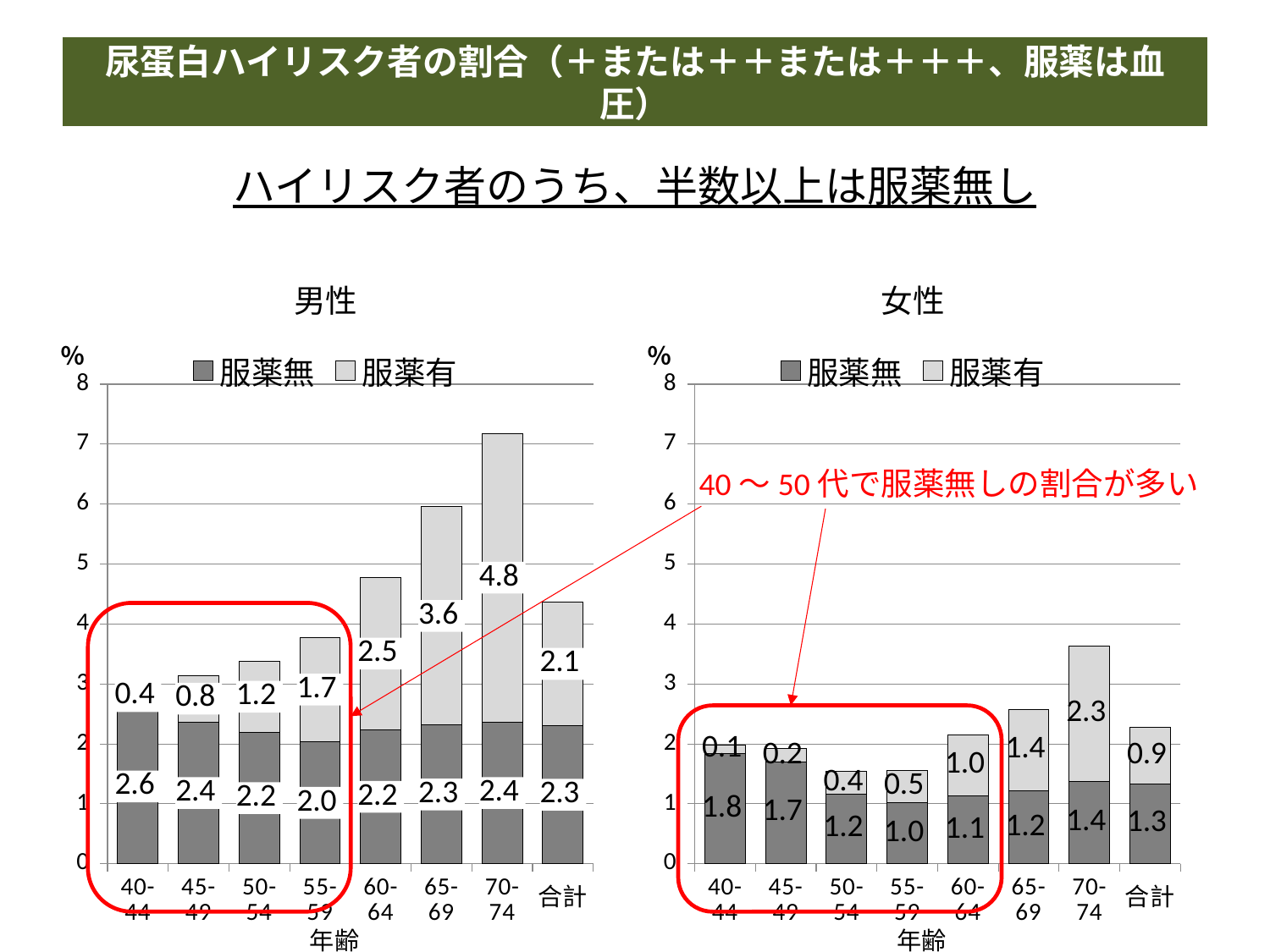
In the 男性 chart, what is the 服薬無 value for the 40-44 age group? 2.6 In the 男性 chart, what is the total height of the stacked bar for the 70-74 age group? 7.2 In the 女性 chart, what is the 服薬有 value for 合計? 0.9 In the 男性 chart, which is larger for the 65-69 age group: 服薬無 or 服薬有? 服薬有 In the 女性 chart, what is the 服薬無 value for the 55-59 age group? 1.0 What kind of chart is the 女性 chart? Stacked bar chart In the 女性 chart, which age group has the lowest 服薬有 value? 40-44 In the 男性 chart, which age group has the highest 服薬有 value? 70-74 How many series does the legend of the 女性 chart list? 2 How many categories are shown on the x axis of the 男性 chart? 8 In the 男性 chart, what is the 服薬有 value for the 70-74 age group? 4.8 In the 女性 chart, what is the difference between the 服薬無 values for 40-44 and 55-59? 0.8